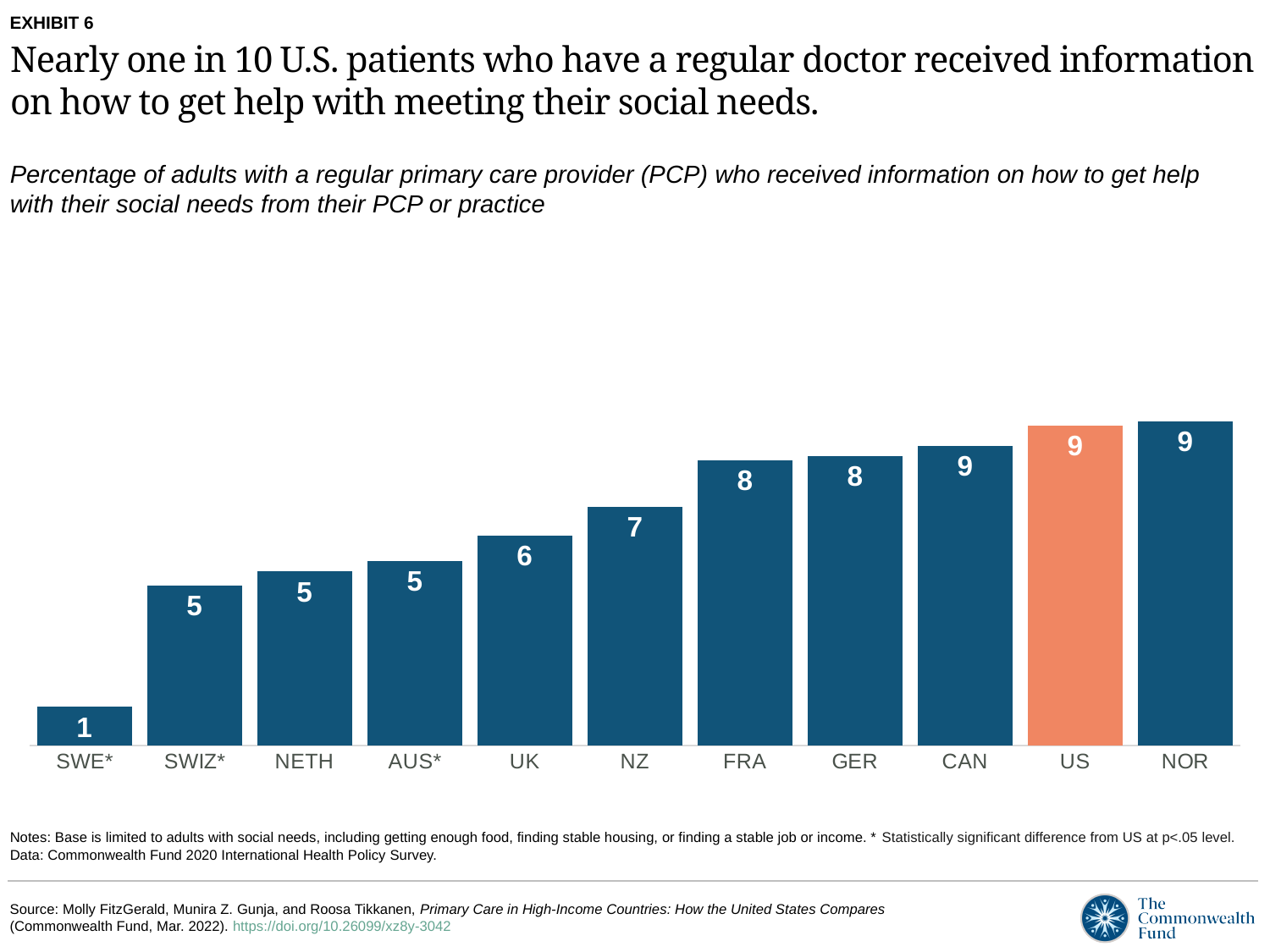
What is the value shown for SWE*? 1 What is the value shown for the UK? 6 What is the difference between the values for NOR and SWE*? 8 What is the value shown for NZ? 7 What kind of chart is shown on the slide? Bar chart Which has a larger value, UK or CAN? CAN What is the value shown for the US bar? 9 How many countries are shown on the chart? 11 What is the difference between the values for FRA and AUS*? 3 Which has a larger value, GER or NETH? GER Which country has the lowest value on the chart? SWE* Do the values generally rise or fall from left to right along the x axis? Rise